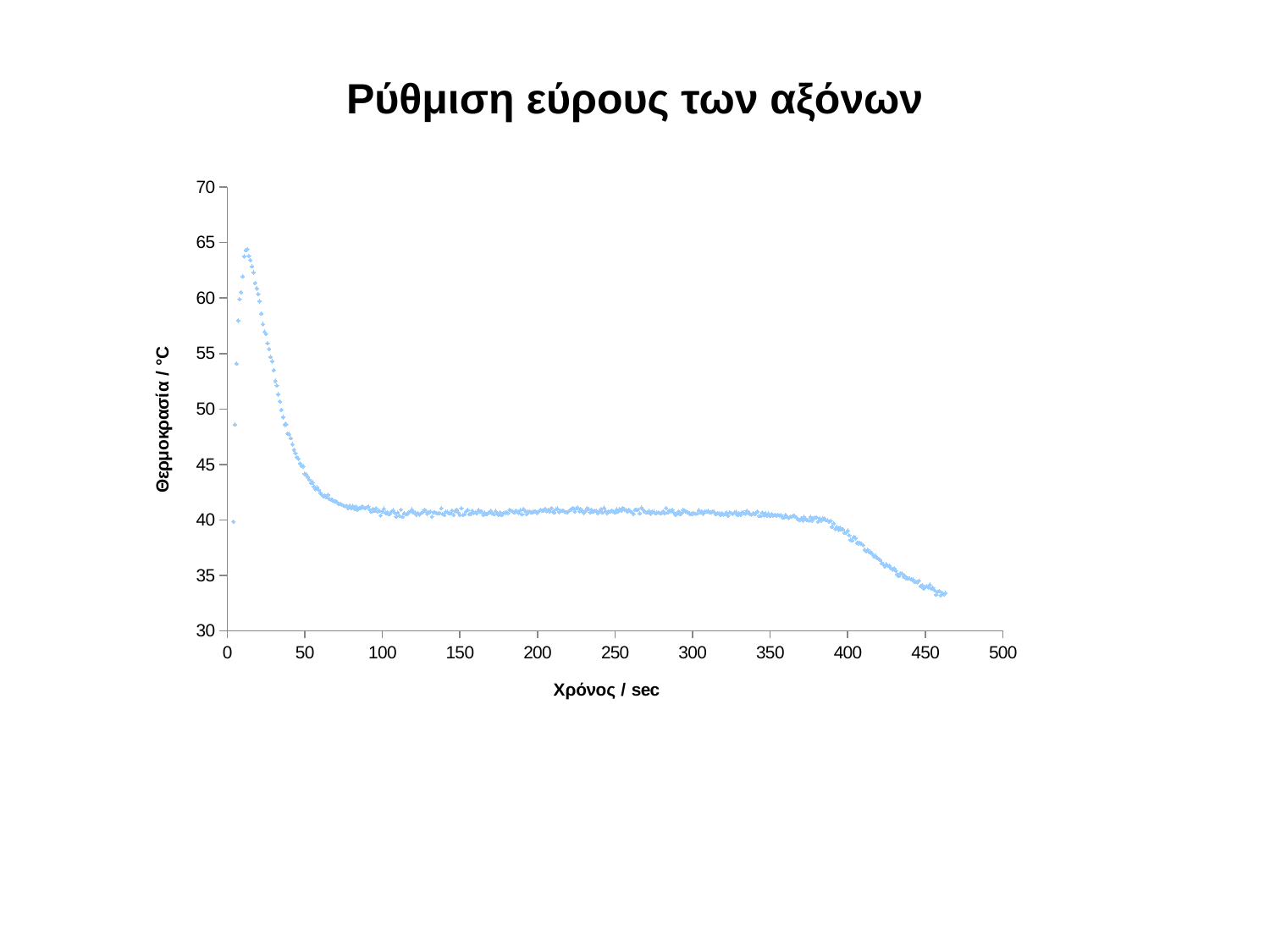
Is the temperature at 200 sec greater or less than 45? less What is the label of the vertical axis? Θερμοκρασία / °C What kind of chart is shown on the slide? Scatter chart Is the temperature at 100 sec greater or less than 35? greater Is the temperature at 250 sec larger or smaller than the temperature at 450 sec? larger What is the title of the chart? Ρύθμιση εύρους των αξόνων Is the temperature at 300 sec greater or less than 50? less Do the temperature values rise or fall between 400 sec and 460 sec? fall Do the temperature values rise or fall between 20 sec and 50 sec? fall Is the temperature at 20 sec larger or smaller than the temperature at 400 sec? larger